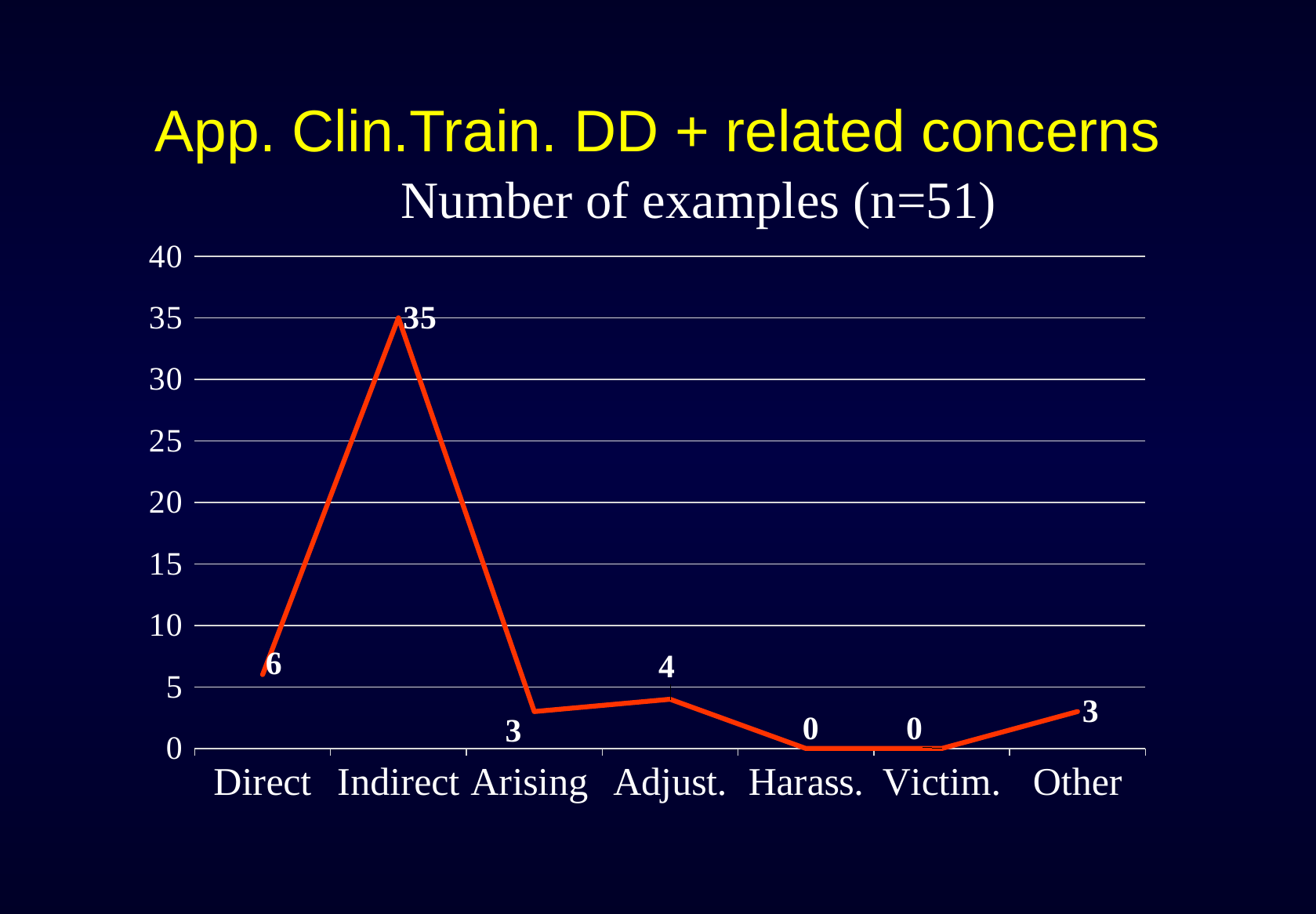
What is the value for Adjust.? 4 How many categories are shown on the x axis? 7 What is the value for Indirect? 35 Which is larger, the value for Direct or the value for Adjust.? Direct What is the value for Other? 3 Which category has the highest value? Indirect What is the value for Direct? 6 Does the value rise or fall from Indirect to Arising? fall What is the difference between the values for Indirect and Direct? 29 Is the value for Indirect greater or less than 30? greater What is the chart's title? Number of examples (n=51) What kind of chart is shown on the slide? line chart